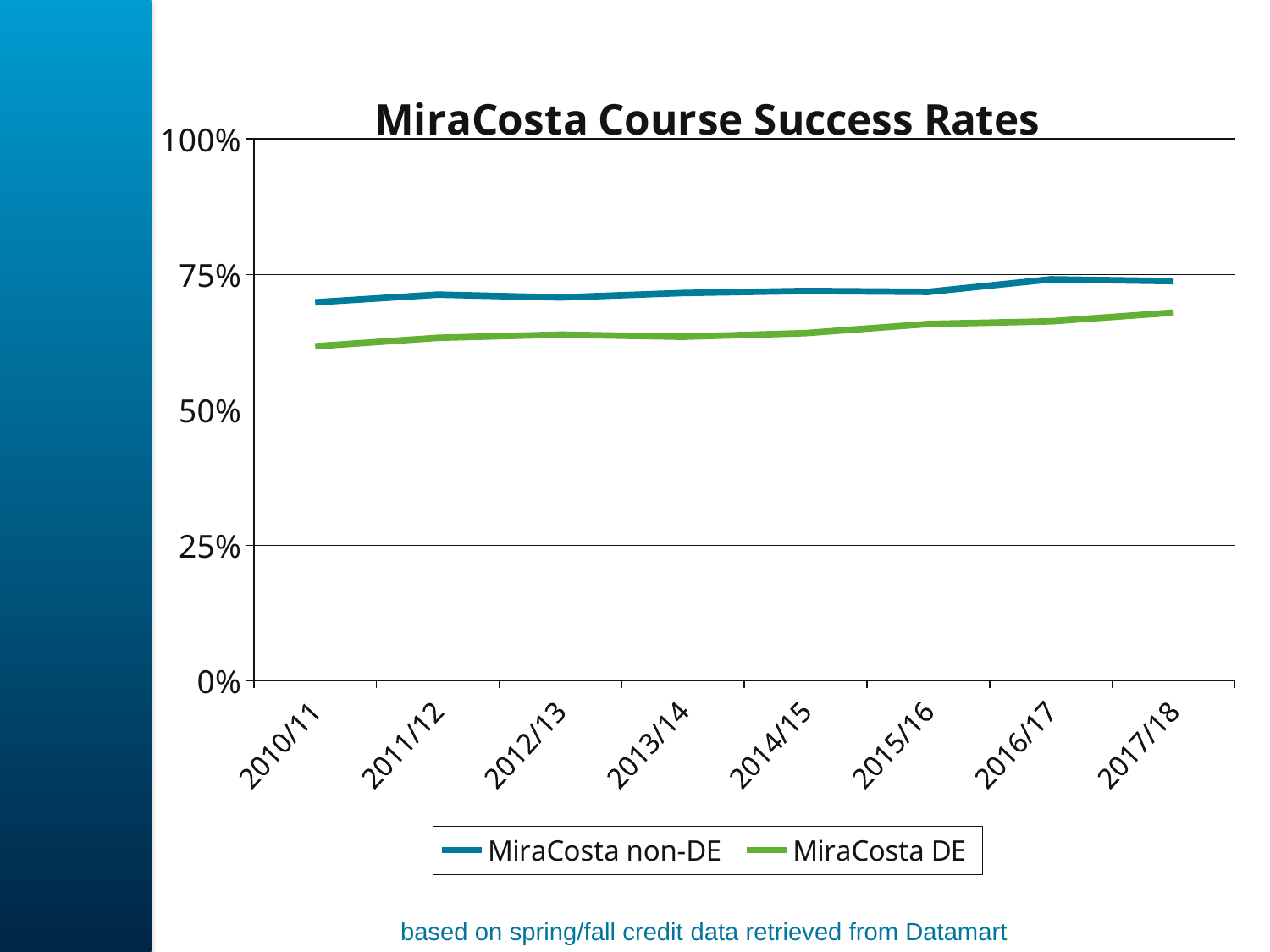
Is the value for MiraCosta DE in 2017/18 greater or less than 50%? greater How many series does the legend list? 2 What is the title of the chart? MiraCosta Course Success Rates How many academic years are plotted along the x axis? 8 Is the value for MiraCosta non-DE in 2010/11 greater or less than 75%? less Which series is plotted in green? MiraCosta DE In which year is the MiraCosta DE success rate highest? 2017/18 In which year is the MiraCosta DE success rate lowest? 2010/11 Does the MiraCosta DE success rate generally rise or fall from 2010/11 to 2017/18? rise What kind of chart is shown on the slide? line chart Is the value for MiraCosta DE in 2010/11 greater or less than 75%? less In 2013/14, which series has the higher success rate, MiraCosta non-DE or MiraCosta DE? MiraCosta non-DE